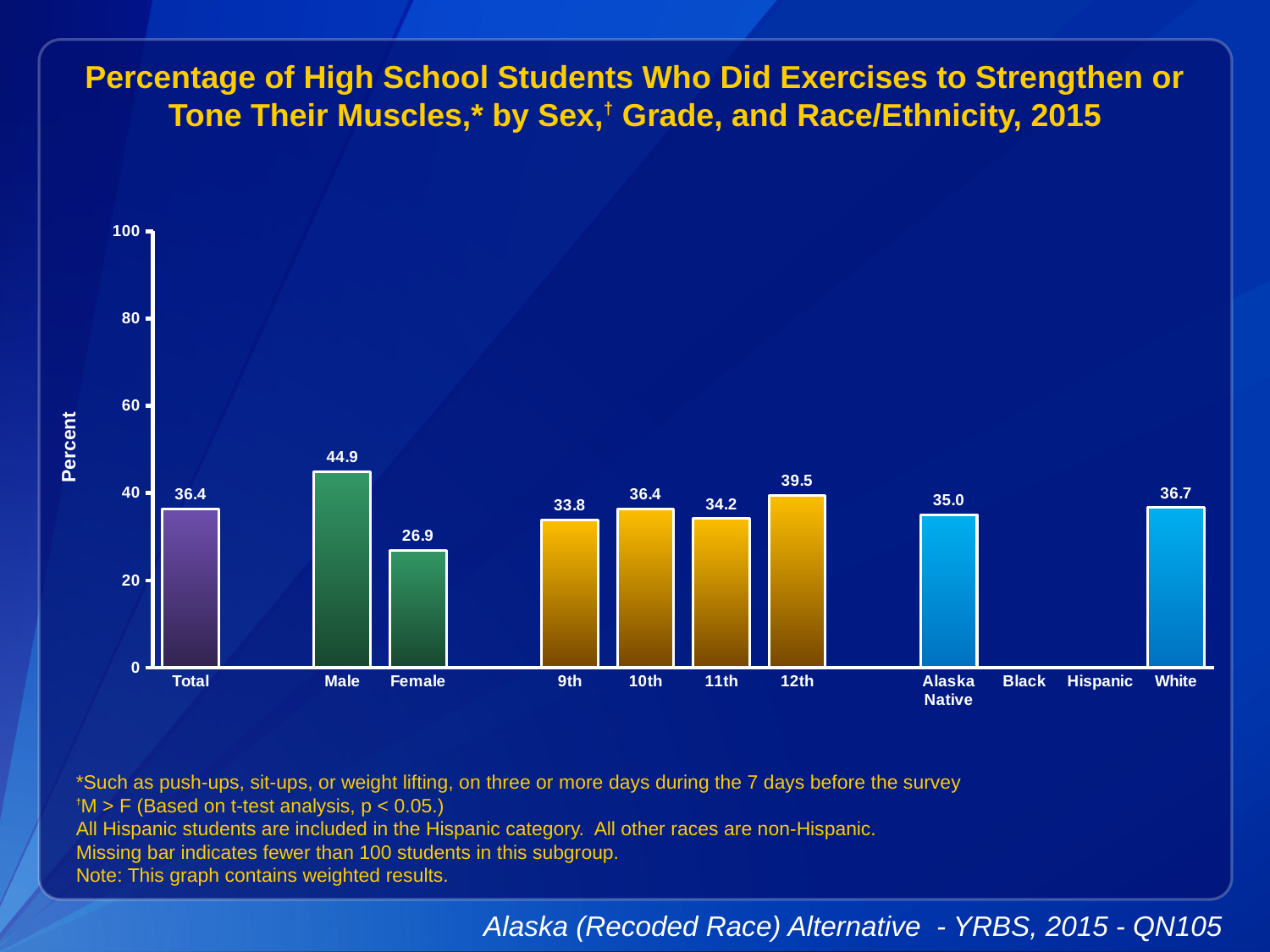
Is the value for Total greater or less than 40? less What is the value for Female? 26.9 What kind of chart is shown? bar chart Which categories have no bar shown? Black and Hispanic What is the value for 12th grade? 39.5 How many categories have a bar plotted? 9 What is the difference between the Male and Female values? 18.0 Which category has the highest value? Male Which is larger, the value for 9th grade or 12th grade? 12th What is the value for Alaska Native? 35.0 Which category has the lowest value among the plotted bars? Female What is the value for Male? 44.9